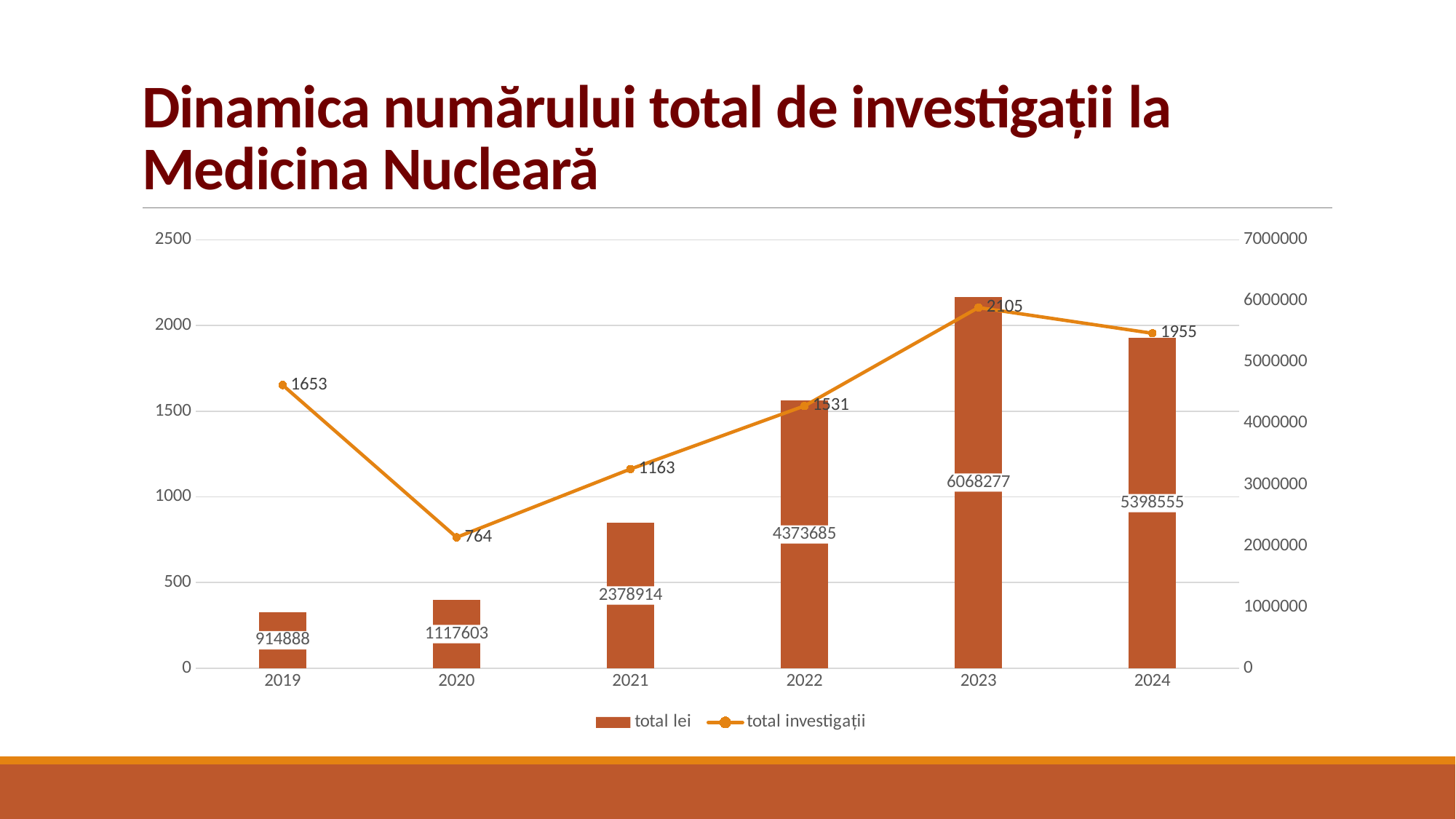
What is the difference between total lei in 2023 and 2022? 1694592 Which is larger, total investigații in 2019 or in 2022? 2019 How many series does the legend list? 2 Which year has the lowest total lei? 2019 What is the value of total lei for 2024? 5398555 What is the difference between total investigații in 2023 and 2024? 150 Which year has the lowest total investigații? 2020 What is the value of total lei for 2021? 2378914 Does total lei rise or fall from 2019 to 2023? rise How many years are shown on the x axis? 6 Which year has the highest total investigații? 2023 What is the value of total investigații for 2020? 764